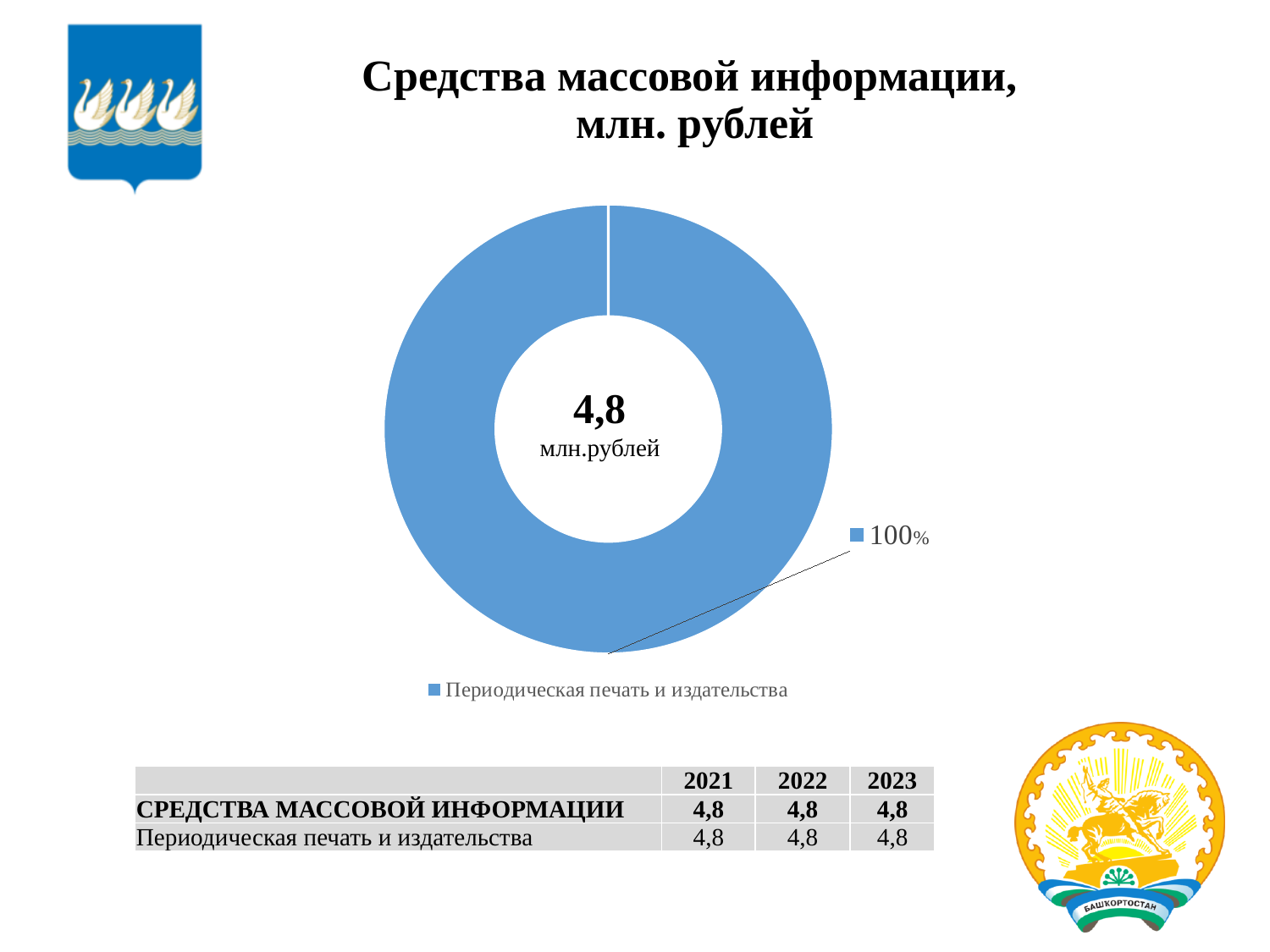
What is the name of the only category shown in the chart legend? Периодическая печать и издательства What value is printed in the centre of the doughnut chart? 4,8 млн.рублей Is the total value shown in the centre of the doughnut chart greater or less than 5 million rubles? less How many slices does the doughnut chart have? 1 What kind of chart is shown on the slide? Doughnut (pie) chart What is the title of the chart on the slide? Средства массовой информации, млн. рублей How many entries does the chart legend list? 1 What share of the doughnut chart does the slice 'Периодическая печать и издательства' take? 100% What percentage label is attached to the single slice of the doughnut chart? 100%